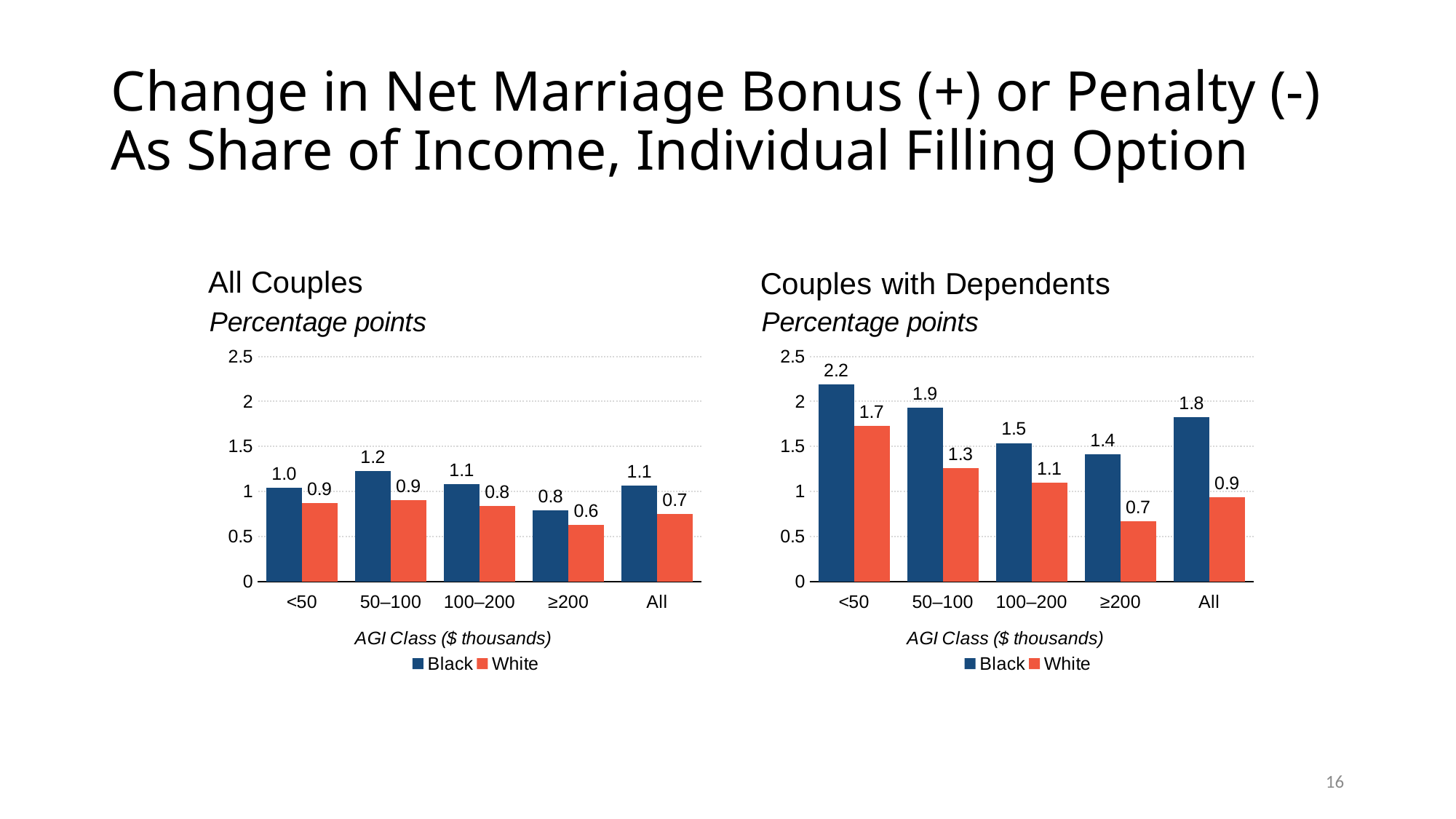
In the All Couples chart, what is the value for Black in the 50–100 AGI class? 1.2 What unit is given below the title of each chart? Percentage points How many AGI class categories are shown on the x axis of the All Couples chart? 5 How many series does the legend of the Couples with Dependents chart list? 2 In the Couples with Dependents chart, do the White values rise or fall from the <50 class to the ≥200 class? Fall In the Couples with Dependents chart, what is the difference between the Black and White values for the All category? 0.9 In the Couples with Dependents chart, which AGI class has the highest value for Black? <50 What kind of chart is the All Couples chart? Bar chart In the Couples with Dependents chart, is the value for Black in the 50–100 AGI class greater or less than 1.5? greater In the All Couples chart, which AGI class has the lowest value for White? ≥200 In the All Couples chart, which is larger for the 100–200 AGI class, Black or White? Black In the Couples with Dependents chart, what is the value for White in the ≥200 AGI class? 0.7